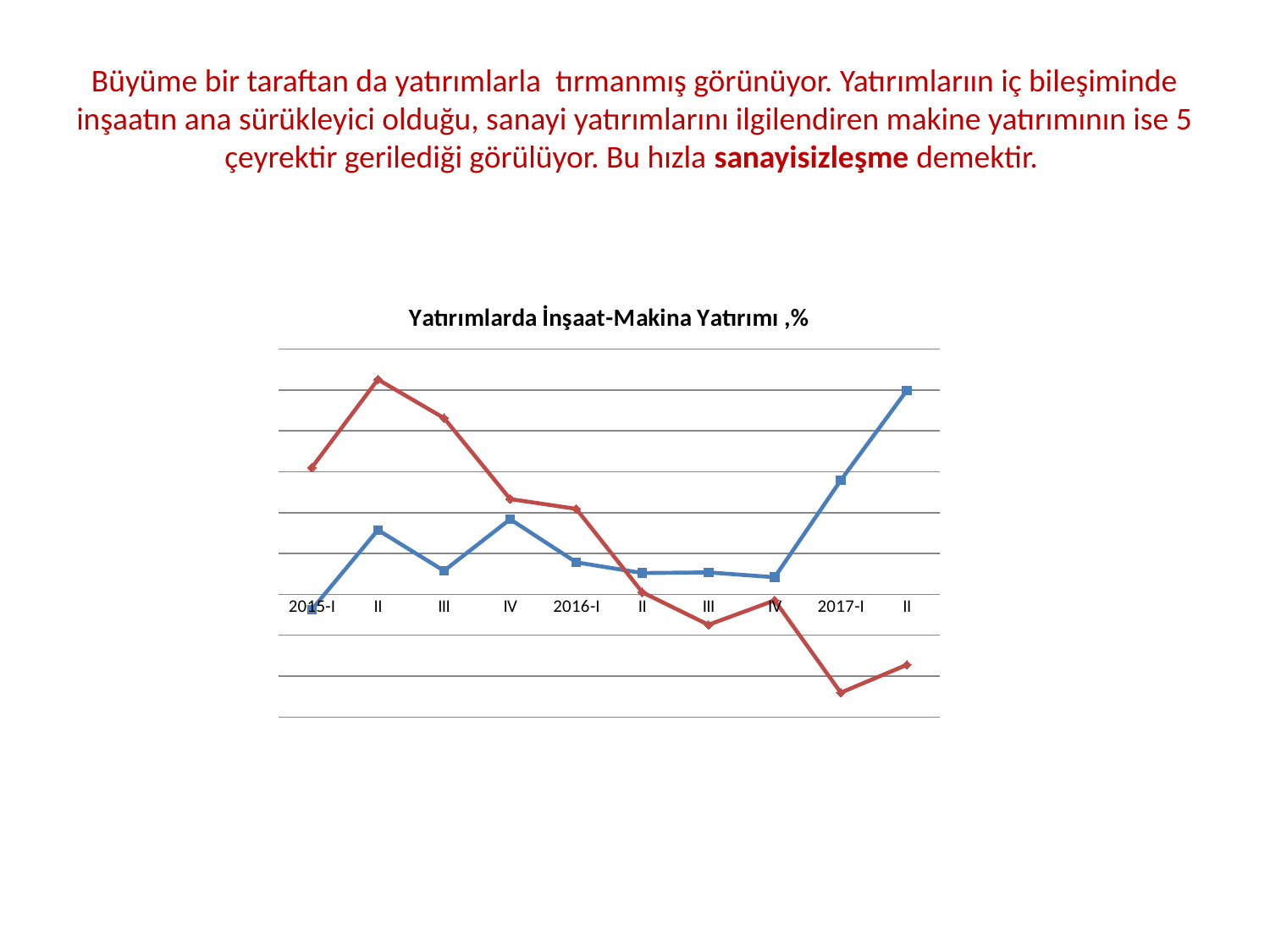
What is the title of the chart? Yatırımlarda İnşaat-Makina Yatırımı ,% What kind of chart is shown on the slide? Line chart Does the blue line rise or fall from 2016-IV to 2017-II? Rise At which quarter does the blue line reach its highest point? 2017-II At which quarter does the blue line reach its lowest point? 2015-I How many quarters are plotted along the x axis of the chart? 10 At 2017-II, which line is higher, the red line or the blue line? Blue line At which quarter does the red line reach its lowest point? 2017-I How many lines are plotted in the chart? 2 Does the red line rise or fall from 2015-II to 2017-I? Fall At 2015-I, which line is higher, the red line or the blue line? Red line At which quarter does the red line reach its highest point? 2015-II